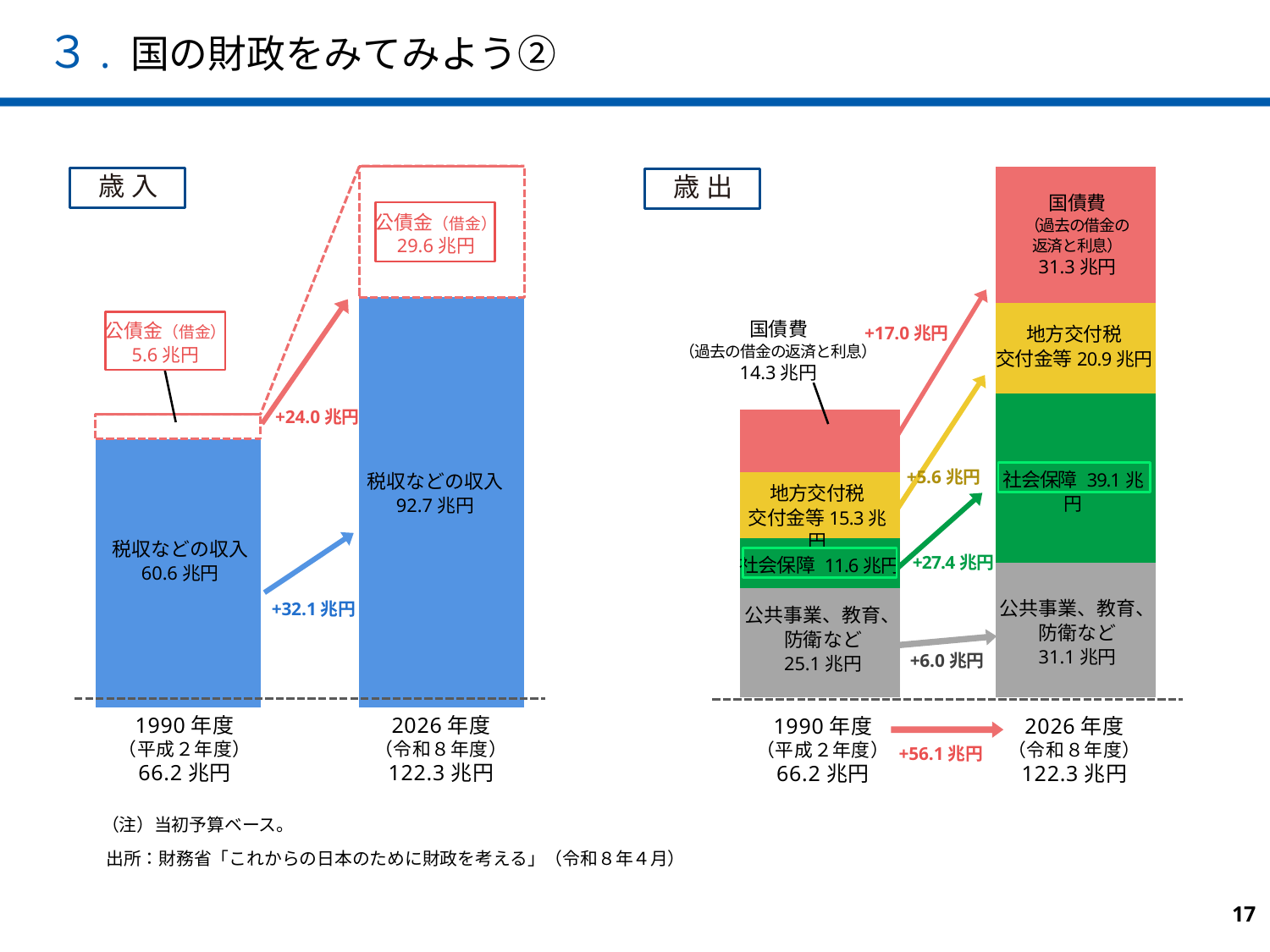
「歳出」のグラフで、2026年度の「国債費」と「公共事業、教育、防衛など」ではどちらが大きいですか？ 国債費 「歳入」のグラフで、2026年度の歳入合計はいくらですか？ 122.3兆円 「歳出」のグラフで、1990年度の歳出合計はいくらですか？ 66.2兆円 「歳出」のグラフで、1990年度の「国債費」はいくらですか？ 14.3兆円 「歳入」のグラフで、1990年度から2026年度にかけて「公債金（借金）」はいくら増えましたか？ +24.0兆円 「歳出」のグラフで、1990年度に最も小さい項目はどれですか？ 社会保障 「歳出」のグラフで、1990年度から2026年度にかけて「社会保障」はいくら増えましたか？ +27.4兆円 「歳入」のグラフで、2026年度の「税収などの収入」はいくらですか？ 92.7兆円 「歳出」のグラフは何種類の項目に積み上げられていますか？ 4 「歳入」のグラフで、1990年度の「公債金（借金）」はいくらですか？ 5.6兆円 「歳出」のグラフで、2026年度に最も大きい項目はどれですか？ 社会保障 「歳出」のグラフで、2026年度の「社会保障」はいくらですか？ 39.1兆円